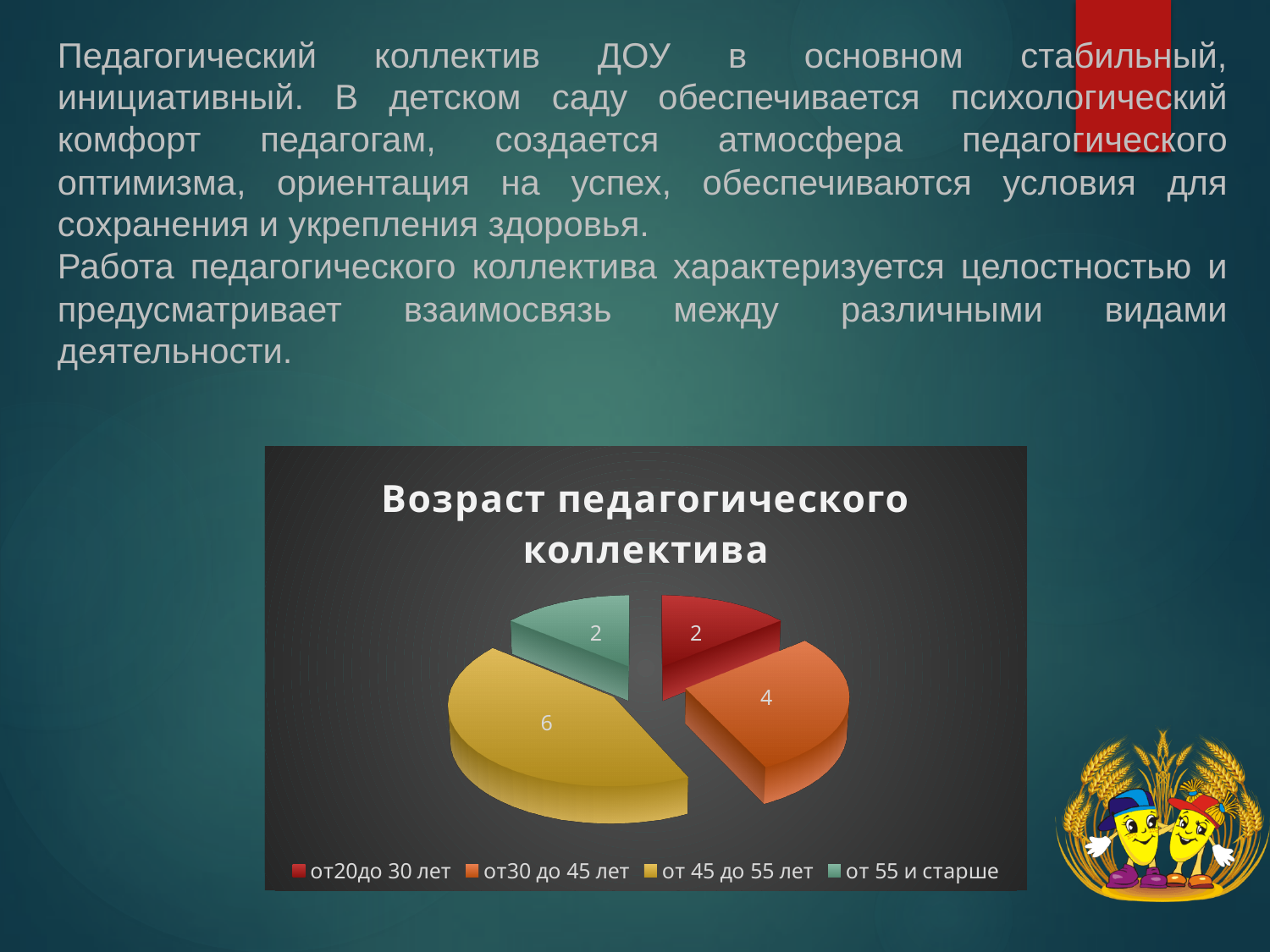
What type of chart is shown on the slide? Pie chart How many categories does the pie chart have? 4 Which age category has the highest value? от 45 до 55 лет What is the value for the category 'от 45 до 55 лет'? 6 What is the value for the category 'от20до 30 лет'? 2 What is the value for the category 'от 55 и старше'? 2 What is the value for the category 'от30 до 45 лет'? 4 Which is larger: the value for 'от30 до 45 лет' or the value for 'от 55 и старше'? от30 до 45 лет What is the total of all the slices in the pie chart? 14 What is the title of the chart? Возраст педагогического коллектива What share of the total does the 'от 45 до 55 лет' slice represent? 6 out of 14 What is the difference between the values for 'от 45 до 55 лет' and 'от30 до 45 лет'? 2